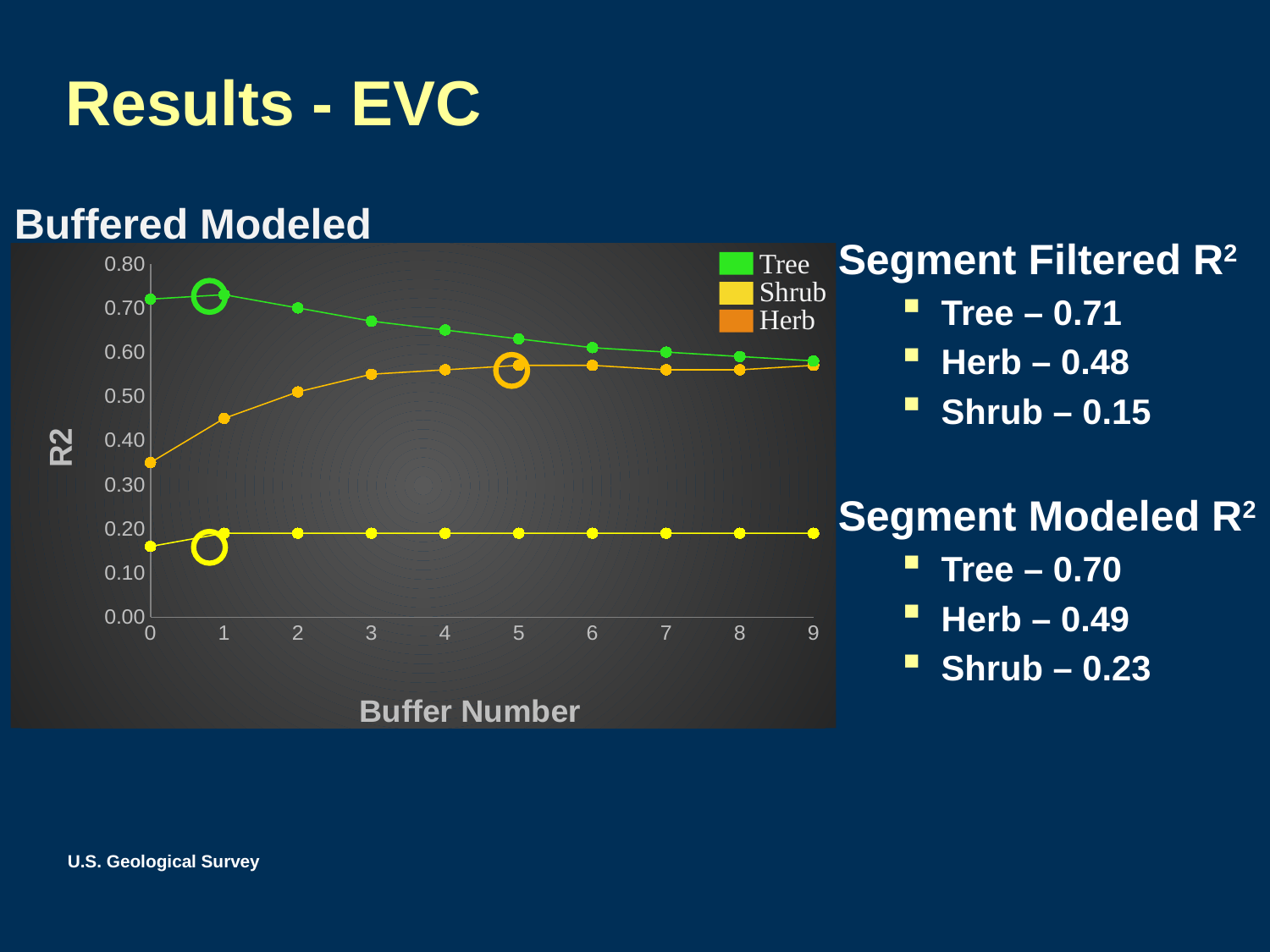
At buffer number 0, which series has the larger value, Tree or Herb? Tree Is the value for Tree at buffer number 0 greater or less than 0.60? greater How many series does the legend of the chart list? 3 How many buffer numbers are plotted along the x axis of the chart? 10 What kind of chart is shown on the slide? line chart What is the title of the x axis of the chart? Buffer Number Is the value for Herb at buffer number 0 greater or less than 0.40? less Which series has the lowest values across all buffer numbers? Shrub Does the Herb series rise or fall as the buffer number increases from 0 to 5? rise Does the Tree series rise or fall as the buffer number increases from 1 to 9? fall Is the value for Shrub at buffer number 5 greater or less than 0.30? less